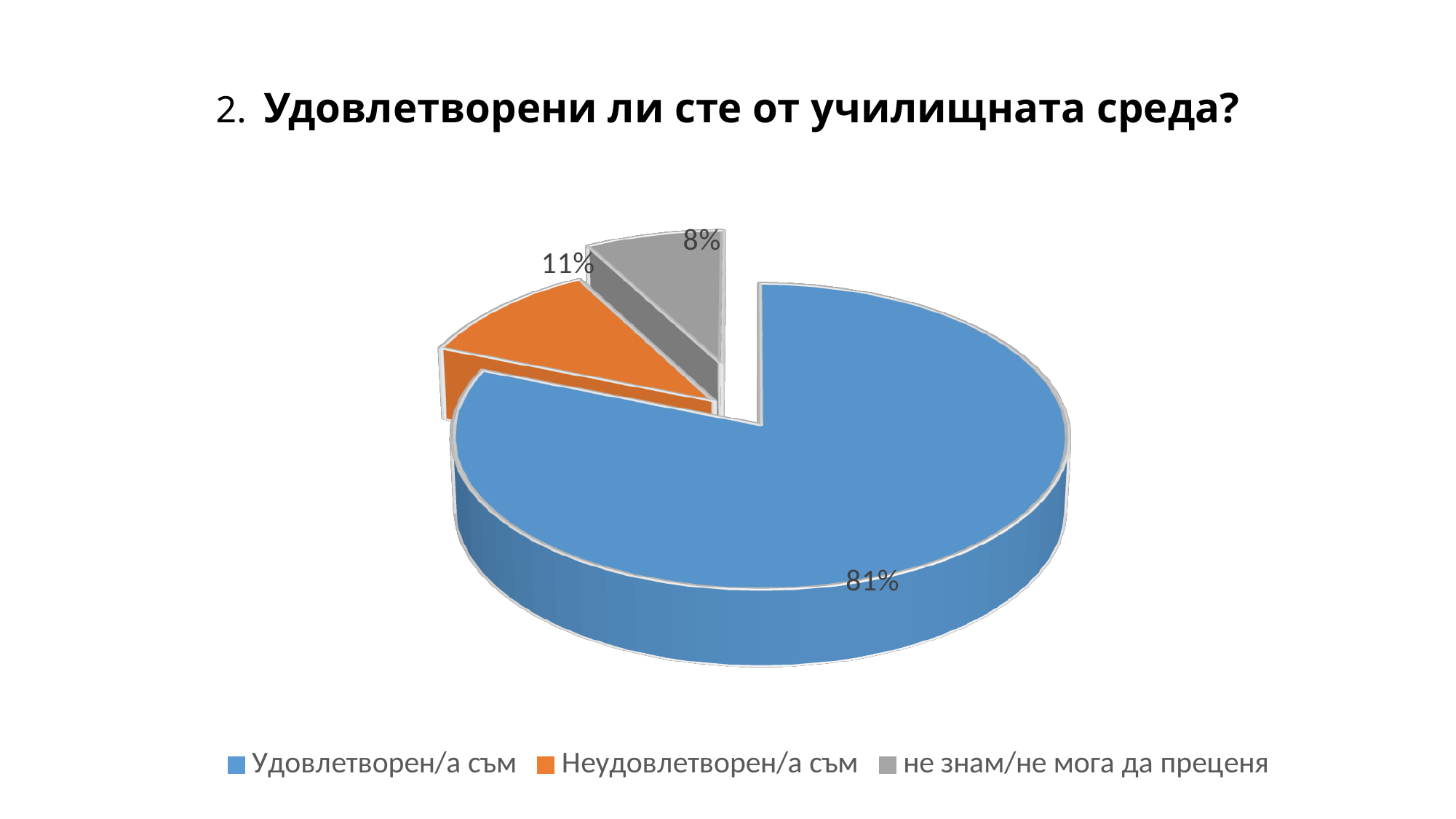
What share of respondents answered "Неудовлетворен/а съм"? 11% What share of respondents answered "Удовлетворен/а съм"? 81% What is the difference in percentage points between "Неудовлетворен/а съм" and "не знам/не мога да преценя"? 3 Which category has the smallest slice of the pie? не знам/не мога да преценя Which is larger: the share for "Неудовлетворен/а съм" or the share for "не знам/не мога да преценя"? Неудовлетворен/а съм What is the title of the chart? Удовлетворени ли сте от училищната среда? What colour is the slice for "Неудовлетворен/а съм"? orange How many categories does the pie chart have? 3 What kind of chart is shown on the slide? pie chart Which category has the largest slice of the pie? Удовлетворен/а съм What is the difference in percentage points between "Удовлетворен/а съм" and "Неудовлетворен/а съм"? 70 What share of respondents answered "не знам/не мога да преценя"? 8%